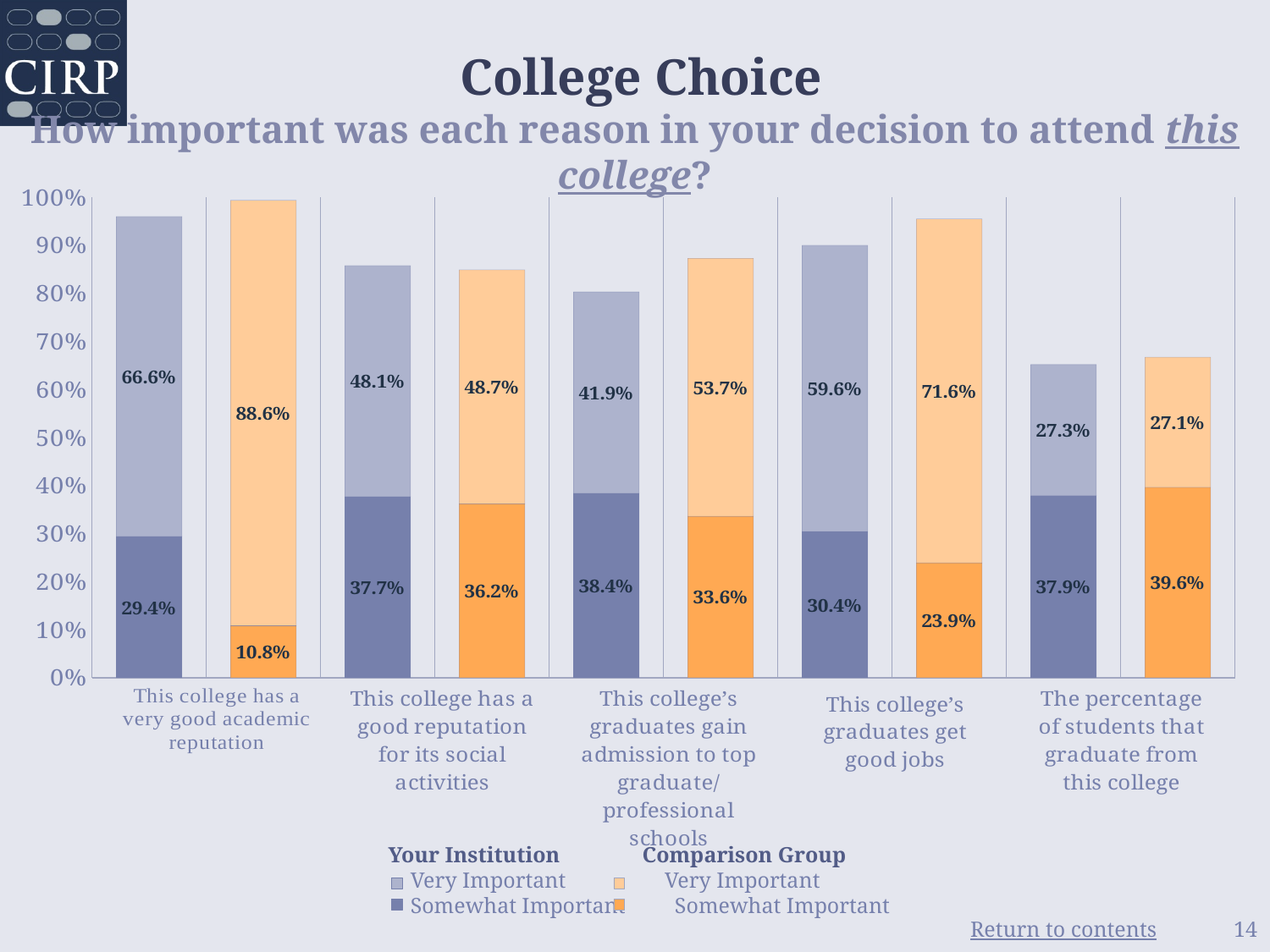
Which reason has the highest Very Important percentage for the Comparison Group? This college has a very good academic reputation For "This college's graduates gain admission to top graduate/professional schools", which group has the larger Very Important percentage, Your Institution or the Comparison Group? Comparison Group What kind of chart is shown on the slide? Stacked bar chart Which reason has the lowest Very Important percentage for Your Institution? The percentage of students that graduate from this college What is the combined total of the Comparison Group bar for "This college has a very good academic reputation"? 99.4% What is the Comparison Group's Very Important value for "This college has a good reputation for its social activities"? 48.7% What is the difference between the Comparison Group's and Your Institution's Very Important values for "This college has a very good academic reputation"? 22.0% How many reasons (categories) are shown on the x axis of the chart? 5 How many series does the legend list? 4 What percentage of the Comparison Group rated "This college's graduates get good jobs" as Somewhat Important? 23.9% What percentage of students at Your Institution rated "This college has a very good academic reputation" as Very Important? 66.6% What is the combined Very Important and Somewhat Important total for Your Institution on "This college's graduates get good jobs"? 90.0%